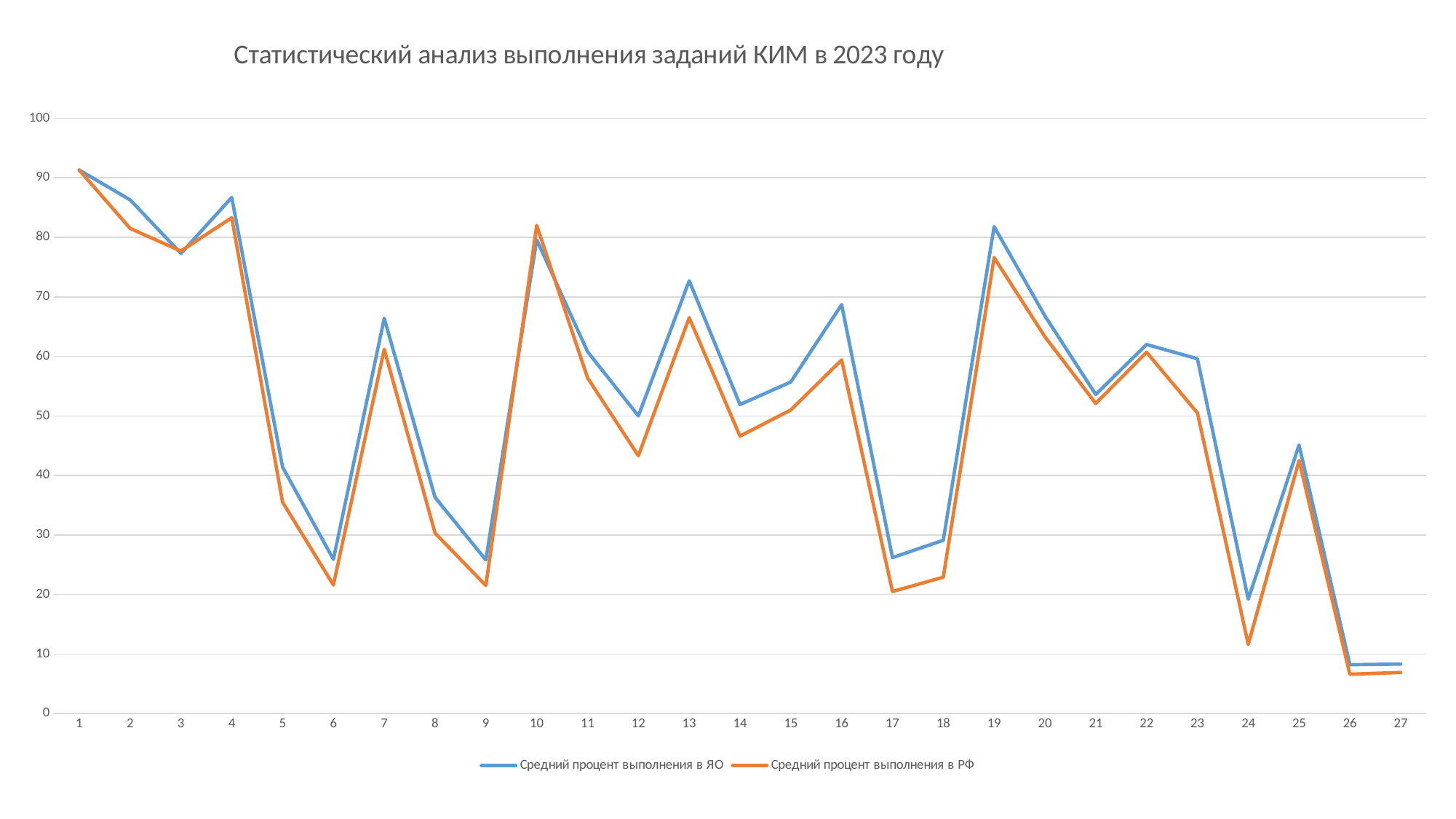
How many series does the legend list? 2 Is the value of 'Средний процент выполнения в РФ' for task 24 greater or less than 20? less Is the value of 'Средний процент выполнения в ЯО' for task 13 greater or less than 70? greater For which task is the value of 'Средний процент выполнения в РФ' highest? 1 What is the title of the chart? Статистический анализ выполнения заданий КИМ в 2023 году How many tasks (points) are plotted along the x axis? 27 Is the value of 'Средний процент выполнения в ЯО' for task 7 greater or less than 60? greater Do the values of 'Средний процент выполнения в ЯО' rise or fall from task 1 to task 3? fall For which task is the value of 'Средний процент выполнения в ЯО' highest? 1 For task 10, which series has the larger value: 'Средний процент выполнения в ЯО' or 'Средний процент выполнения в РФ'? Средний процент выполнения в РФ What kind of chart is shown on the slide? line chart